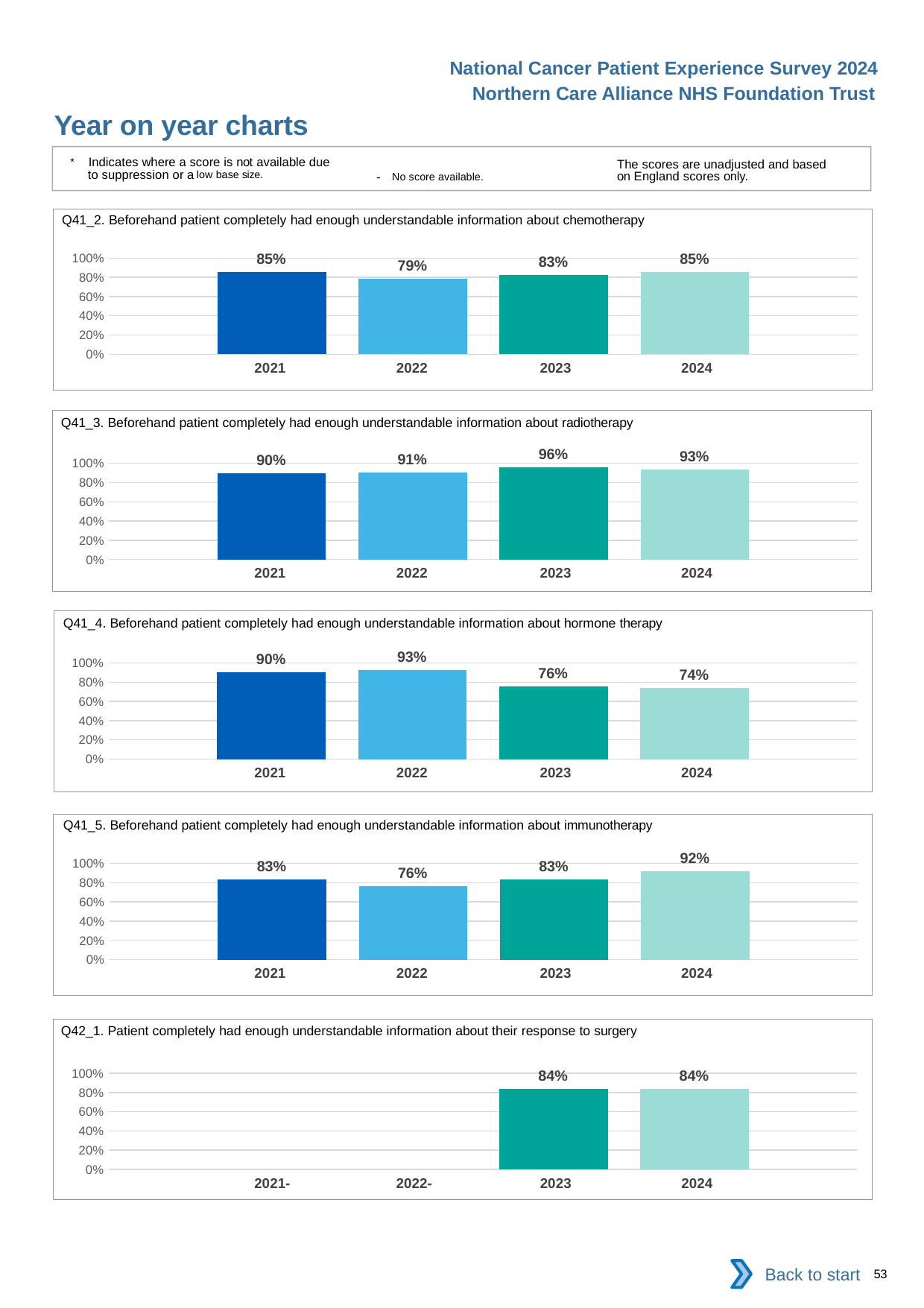
In the Q41_4 hormone therapy chart, what is the difference between the 2022 and 2023 values? 17% In the Q41_5 immunotherapy chart, what is the value for 2024? 92% In the Q41_3 radiotherapy chart, what is the value for 2024? 93% In the Q41_2 chemotherapy chart, what is the difference between the 2021 and 2022 values? 6% In the Q41_5 immunotherapy chart, which is larger, the value for 2022 or the value for 2024? 2024 In the Q41_4 hormone therapy chart, do the values rise or fall from 2022 to 2024? Fall In the Q41_4 hormone therapy chart, which year has the lowest value? 2024 In the Q41_2 chemotherapy chart, what is the value for 2022? 79% In the Q42_1 surgery chart, how many years have a bar plotted? 2 In the Q41_3 radiotherapy chart, which year has the highest value? 2023 In the Q42_1 surgery chart, what is the value for 2023? 84% What type of chart is the Q41_2 chemotherapy chart? Bar chart